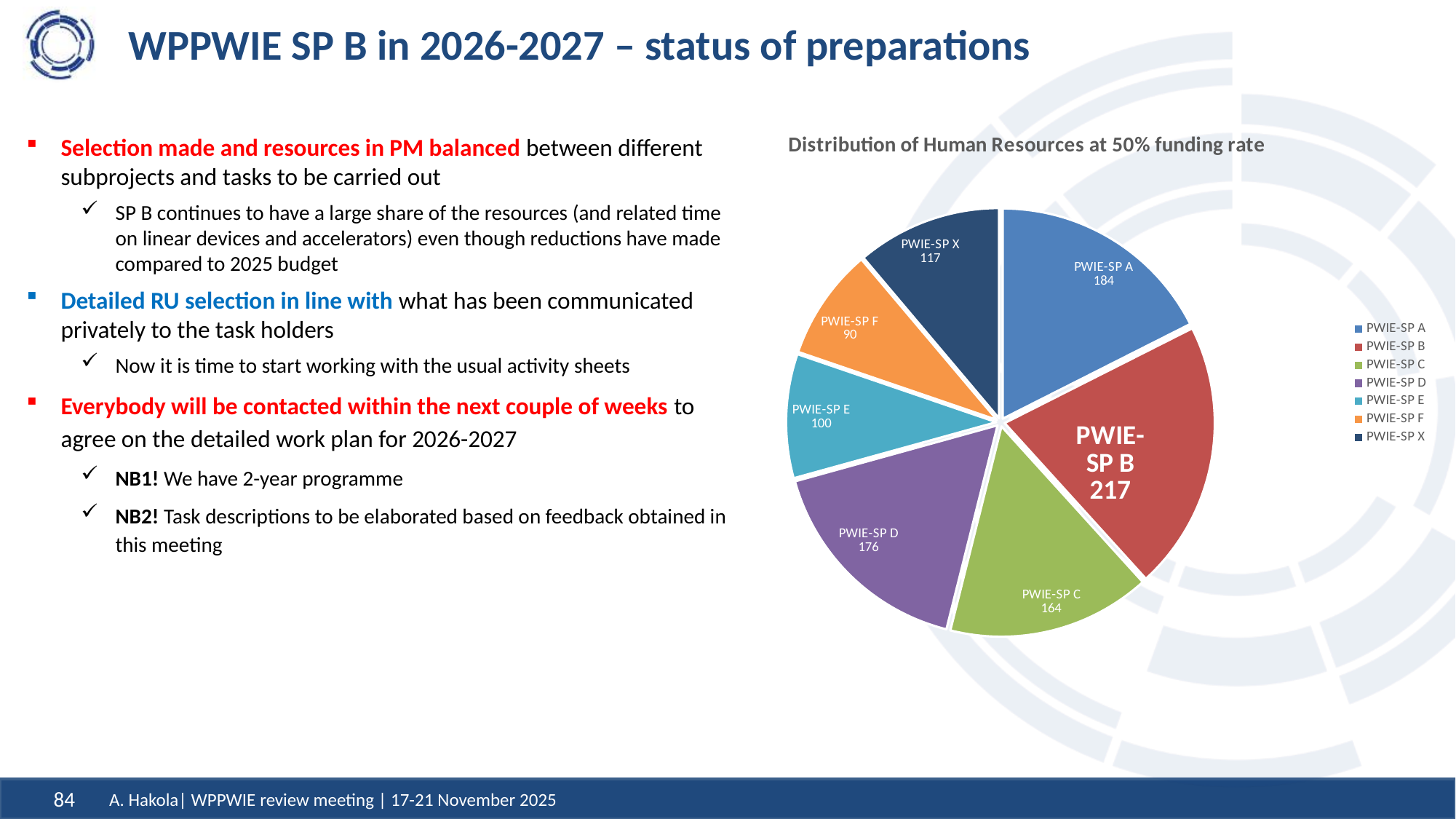
Which is larger, the value for PWIE-SP D or PWIE-SP C? PWIE-SP D What share of the total does PWIE-SP B represent? 20.7% What is the value for PWIE-SP B? 217 Which subproject has the largest slice of the pie? PWIE-SP B What is the difference between the values for PWIE-SP B and PWIE-SP A? 33 What is the title of the chart? Distribution of Human Resources at 50% funding rate What is the value for PWIE-SP E? 100 Which subproject has the smallest slice of the pie? PWIE-SP F How many slices does the pie chart have? 7 What kind of chart is shown on the slide? Pie chart What is the difference between the values for PWIE-SP D and PWIE-SP C? 12 What is the value for PWIE-SP X? 117